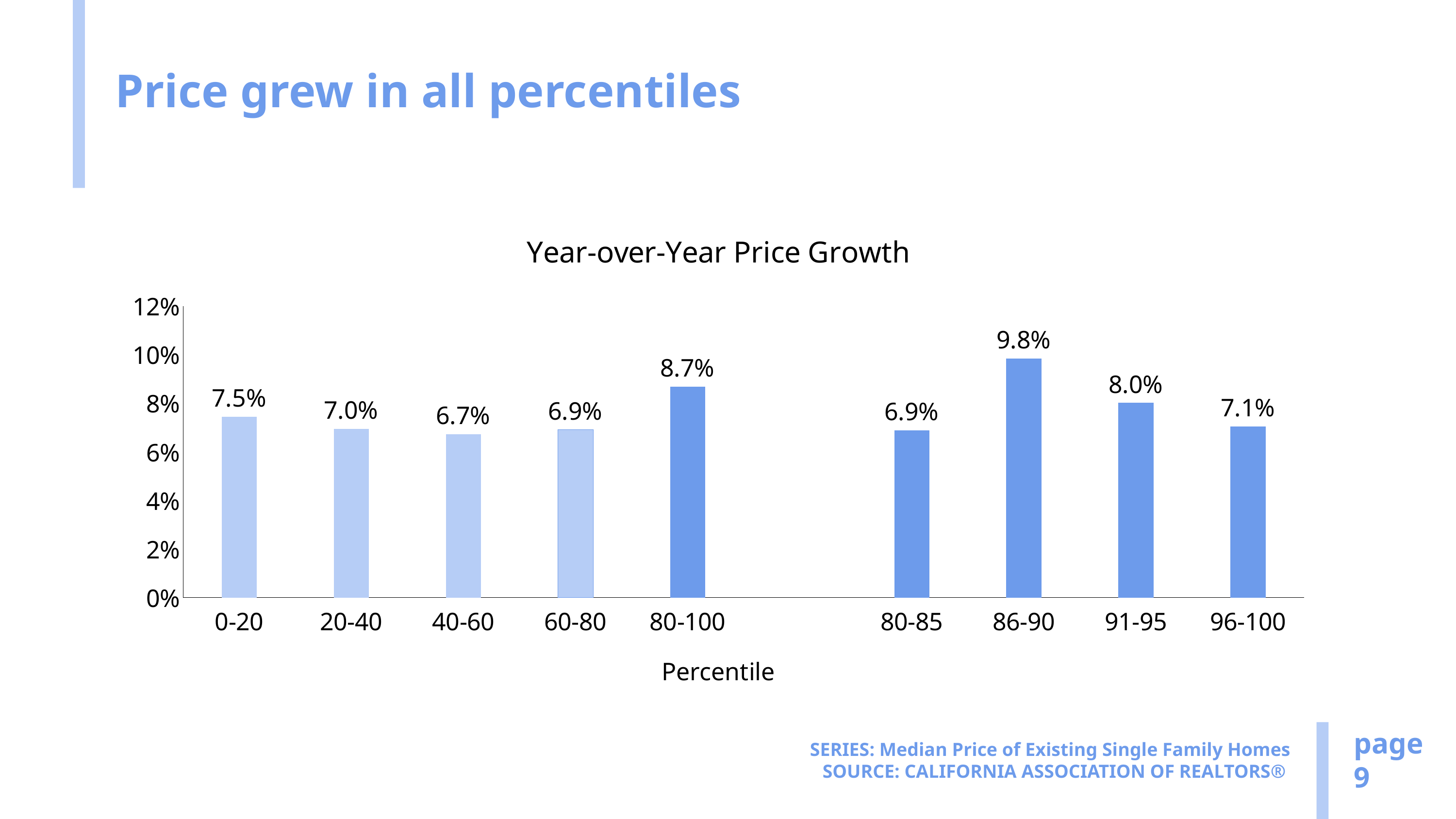
Which percentile group has the highest year-over-year price growth? 86-90 What is the difference in price growth between the 86-90 percentile and the 80-85 percentile? 2.9% What is the year-over-year price growth for the 0-20 percentile? 7.5% What is the year-over-year price growth for the 91-95 percentile? 8.0% What kind of chart is shown on the slide? Bar chart What is the difference in price growth between the 80-100 percentile and the 0-20 percentile? 1.2% What is the year-over-year price growth for the 86-90 percentile? 9.8% What is the title of the chart? Year-over-Year Price Growth Which percentile group has the lowest year-over-year price growth? 40-60 How many percentile groups are shown on the chart? 9 Which has higher price growth, the 80-100 percentile or the 91-95 percentile? 80-100 Is the value for the 86-90 percentile greater or less than 8%? greater